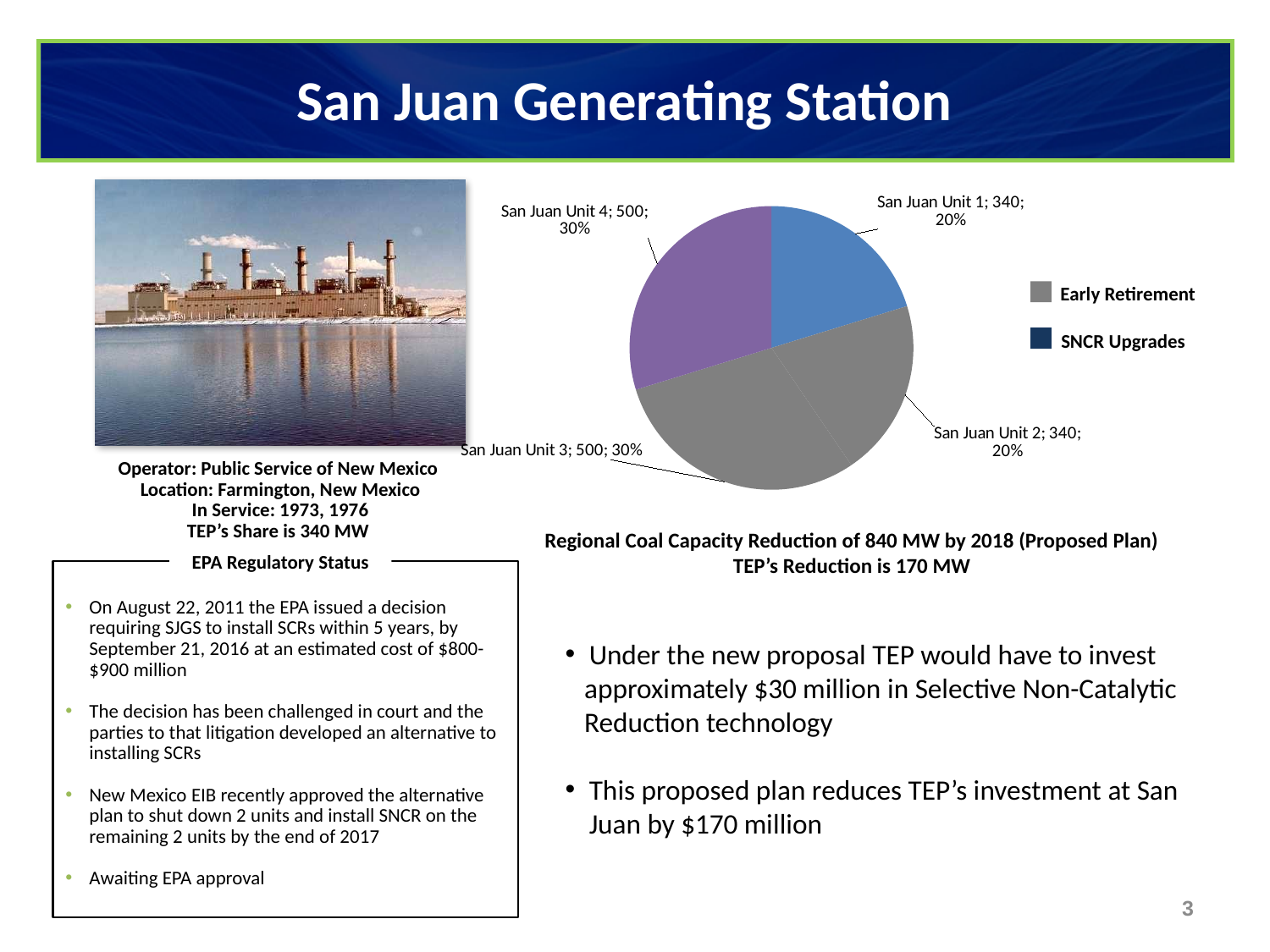
What is the difference between the values for San Juan Unit 4 and San Juan Unit 2? 160 How many slices does the pie chart have? 4 What are the two entries in the legend next to the pie chart? Early Retirement and SNCR Upgrades Which is larger in the pie chart, San Juan Unit 3 or San Juan Unit 1? San Juan Unit 3 What value is shown for San Juan Unit 4 in the pie chart? 500 What value is shown for San Juan Unit 1 in the pie chart? 340 What percentage share of the pie does San Juan Unit 4 represent? 30% What type of chart is shown on the slide? Pie chart What percentage share of the pie does San Juan Unit 2 represent? 20% What value is shown for San Juan Unit 3 in the pie chart? 500 Which slices of the pie chart have the largest share? San Juan Unit 3 and San Juan Unit 4 How many entries does the legend next to the pie chart list? 2